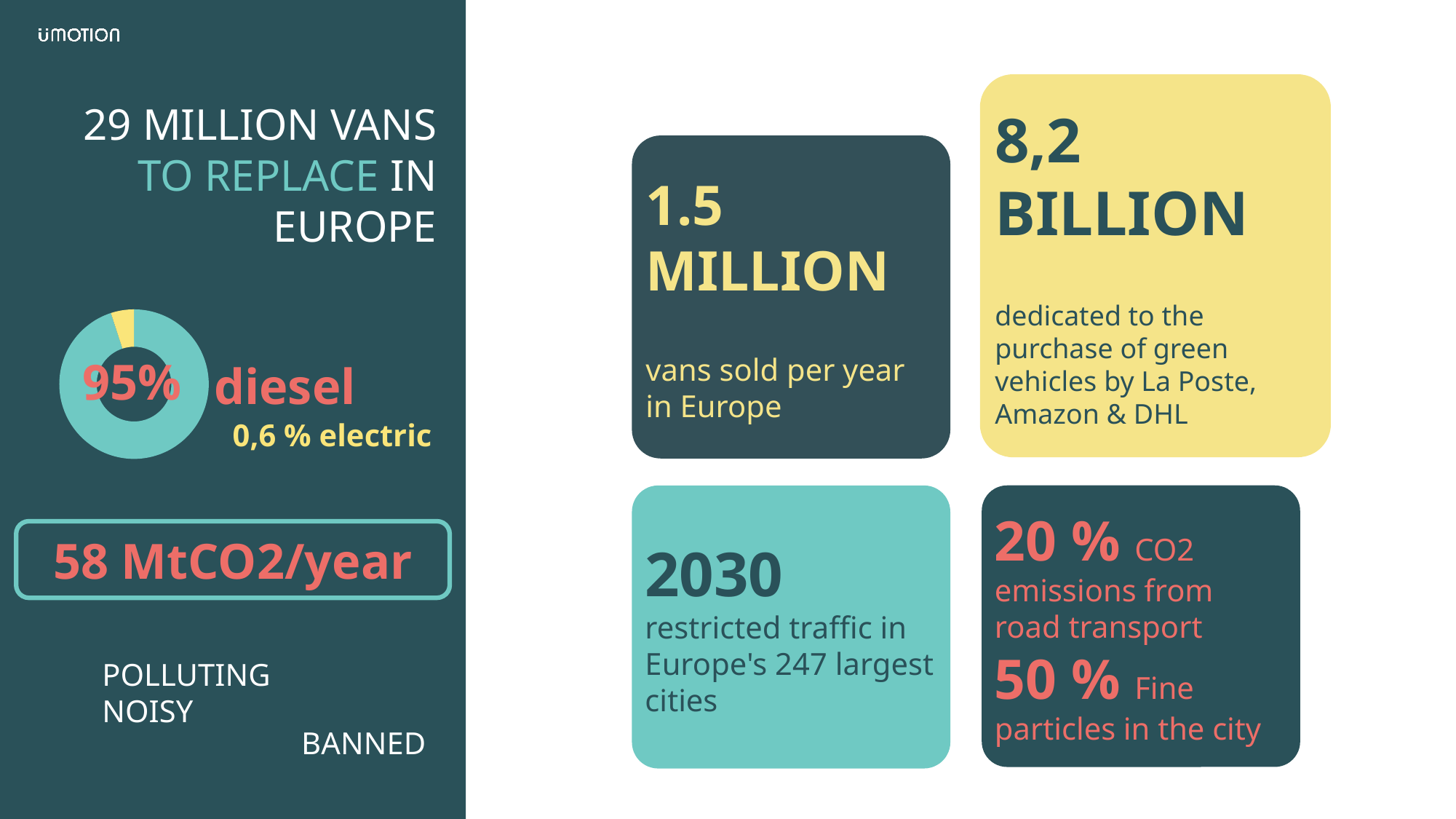
What share of vans does the donut chart show as diesel? 95% What kind of chart is shown on the left side of the slide? pie chart (donut) How many categories are labelled on the donut chart? 2 Is the diesel share in the donut chart greater or less than 50%? greater What share of vans does the donut chart show as electric? 0,6 % What is the difference between the diesel share and the electric share shown on the donut chart? 94,4 % What colour is the small slice of the donut chart? yellow Which is larger in the donut chart, the diesel share or the electric share? diesel What colour is the diesel slice of the donut chart? teal Which category has the largest slice in the donut chart? diesel Which labelled category has the smallest share in the donut chart? electric